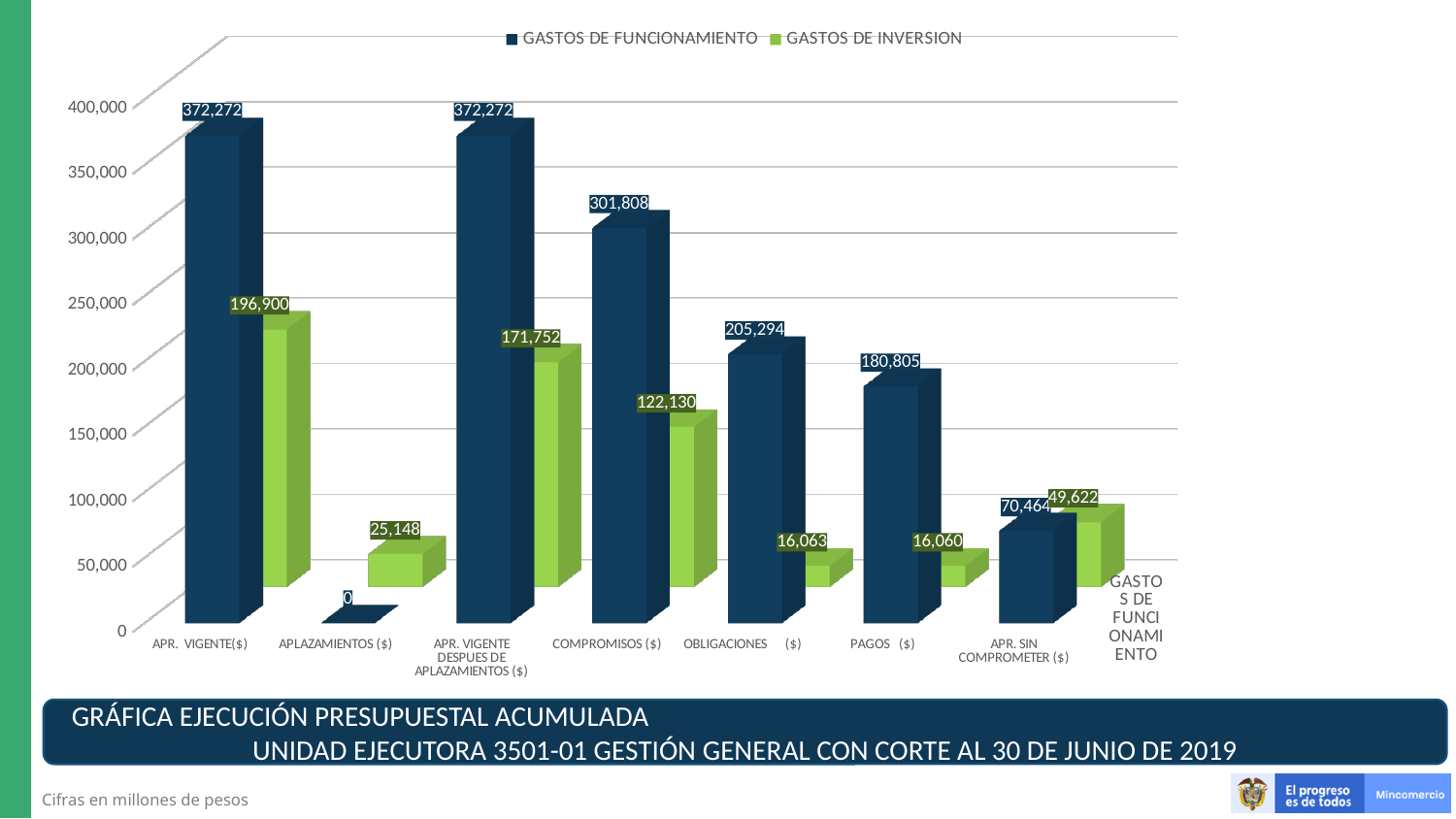
What is the value of GASTOS DE FUNCIONAMIENTO for COMPROMISOS ($)? 301,808 What is the difference between GASTOS DE FUNCIONAMIENTO and GASTOS DE INVERSION for OBLIGACIONES ($)? 189,231 How many categories are shown on the x axis? 7 What is the value of GASTOS DE FUNCIONAMIENTO for APR. SIN COMPROMETER ($)? 70,464 What is the value of GASTOS DE INVERSION for APLAZAMIENTOS ($)? 25,148 Which category has the highest GASTOS DE INVERSION value? APR. VIGENTE($) What kind of chart is shown on the slide? Bar chart Which is larger for PAGOS ($): GASTOS DE FUNCIONAMIENTO or GASTOS DE INVERSION? GASTOS DE FUNCIONAMIENTO Which category has the lowest GASTOS DE FUNCIONAMIENTO value? APLAZAMIENTOS ($) What is the value of GASTOS DE INVERSION for APR. VIGENTE($)? 196,900 How many series does the legend list? 2 What colour represents GASTOS DE INVERSION in the chart? Green